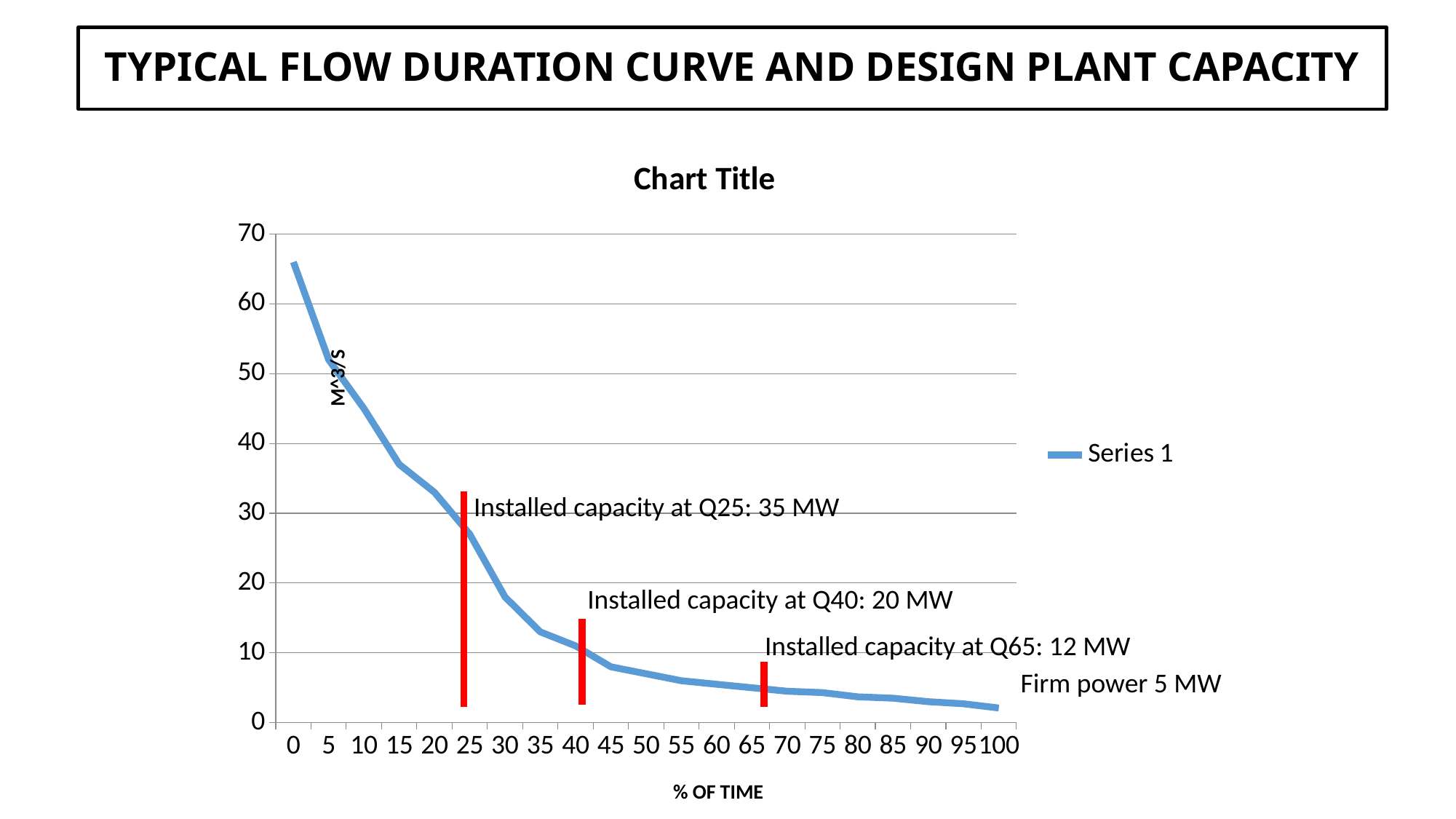
Is the value of Series 1 at 10% of time greater or less than 40? greater What is the name of the series shown in the legend? Series 1 Is the value of Series 1 at 50% of time greater or less than 10? less How many series does the legend list? 1 Is the value of Series 1 at 100% of time greater or less than 10? less Do the values of Series 1 rise or fall as % OF TIME increases from 0 to 100? fall At which % of time value is Series 1 highest? 0 At which % of time value is Series 1 lowest? 100 What kind of chart is shown on the slide? line chart What is the title of the x axis? % OF TIME